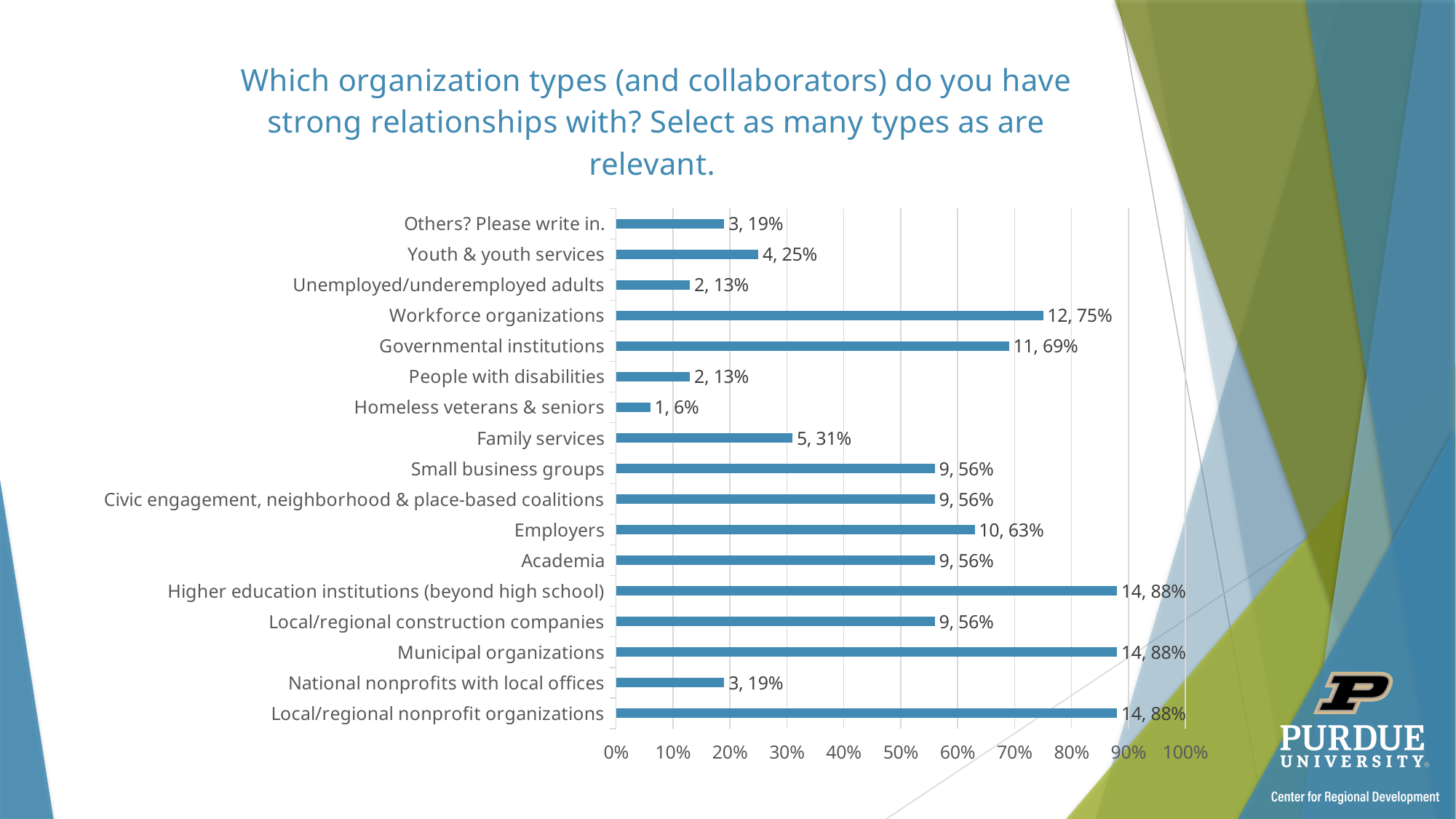
Which category has the lowest value? Homeless veterans & seniors What is the difference in count between Higher education institutions (beyond high school) and Academia? 5 What is the data label for Homeless veterans & seniors? 1, 6% What is the highest value shown on the x axis? 100% What is the difference in percentage points between Workforce organizations and Governmental institutions? 6 Which is larger, the value for Youth & youth services or the value for Family services? Family services What kind of chart is shown on the slide? Bar chart What percentage is shown for Employers? 63% How many respondents selected Governmental institutions? 11 How many categories are plotted on the chart? 17 What percentage is shown for Workforce organizations? 75% Is the value for Municipal organizations greater or less than 80%? greater